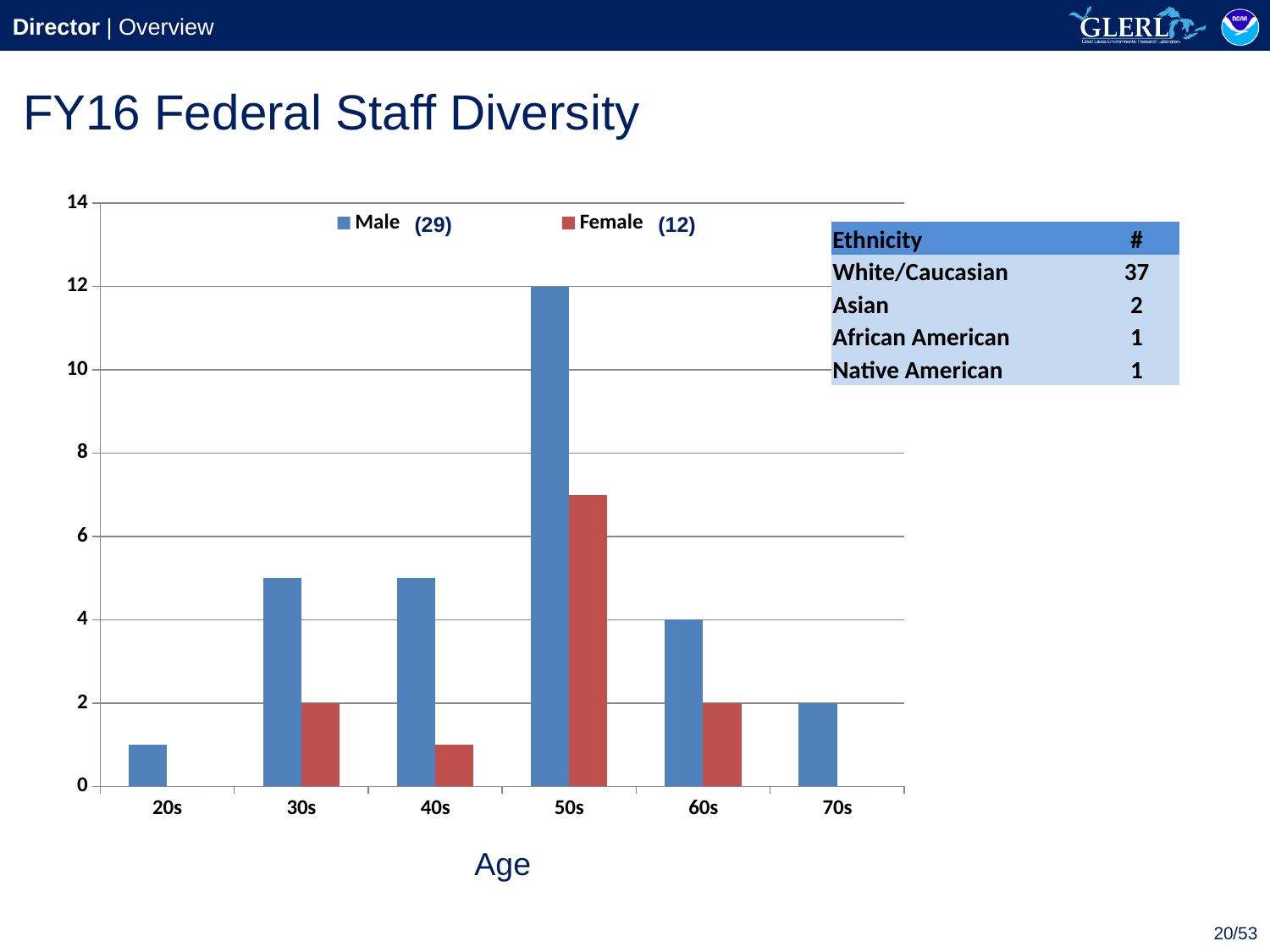
What is the Male value for the 60s age group? 4 Is the Female value for the 50s age group greater or less than 6? greater What kind of chart is shown on the slide? bar chart Which is larger for the 60s age group, the Male value or the Female value? Male What total is shown next to the Male entry in the legend? (29) What is the Female value for the 30s age group? 2 Which age group has the highest Male value? 50s Is the Male value for the 30s age group greater or less than 4? greater What is the Male value for the 50s age group? 12 How many age categories are shown on the x axis? 6 Which age group has the highest Female value? 50s How many series does the legend list? 2